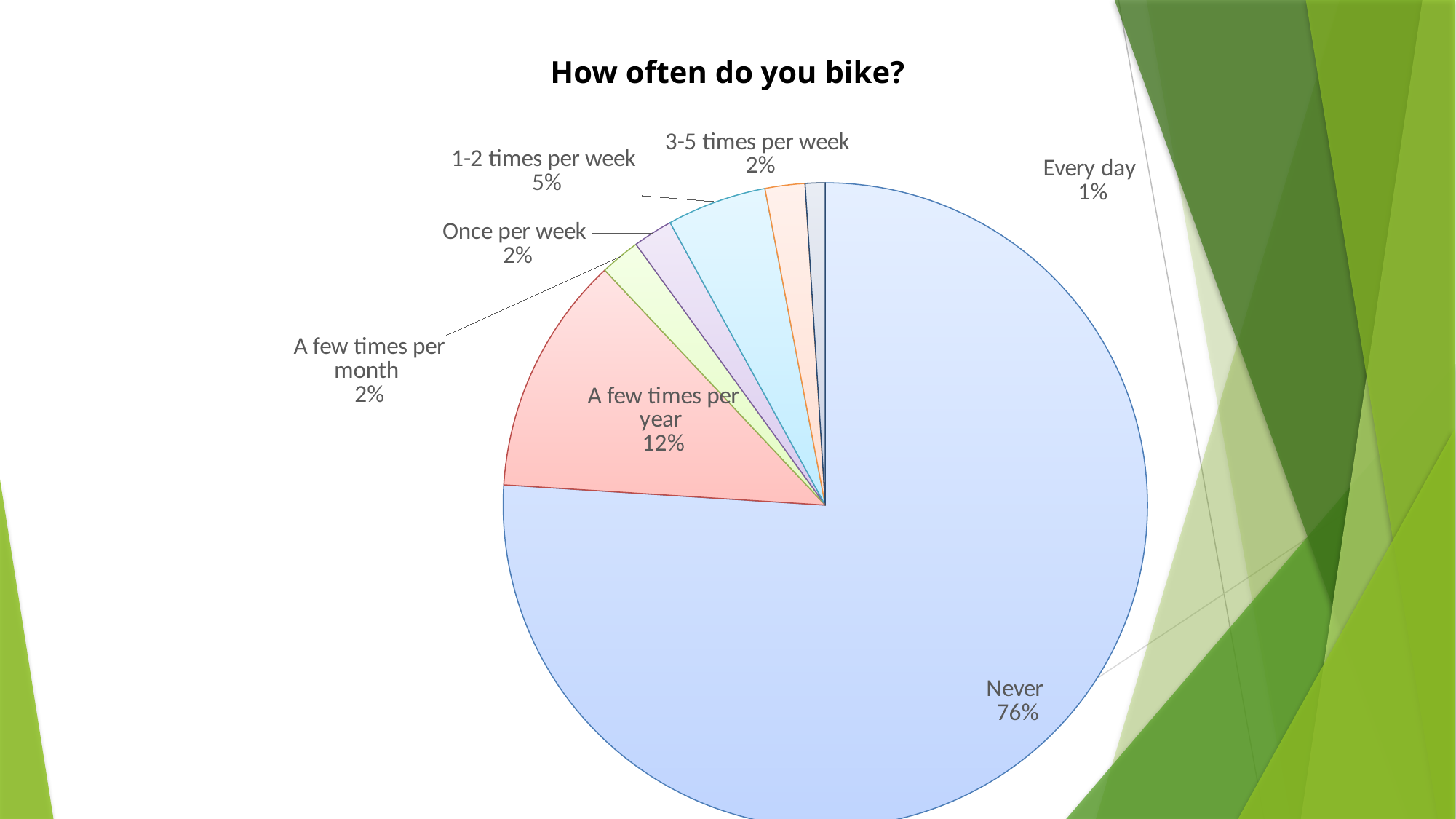
What share of respondents bike a few times per year? 12% Which is larger, the share for "1-2 times per week" or the share for "Once per week"? 1-2 times per week What kind of chart is shown on the slide? pie chart Which category has the smallest slice of the pie? Every day How many categories are shown in the pie chart? 7 What share of respondents bike every day? 1% What share of respondents bike 3-5 times per week? 2% Which category has the largest slice of the pie? Never What is the title of the chart? How often do you bike? What is the difference in percentage points between "Never" and "A few times per year"? 64